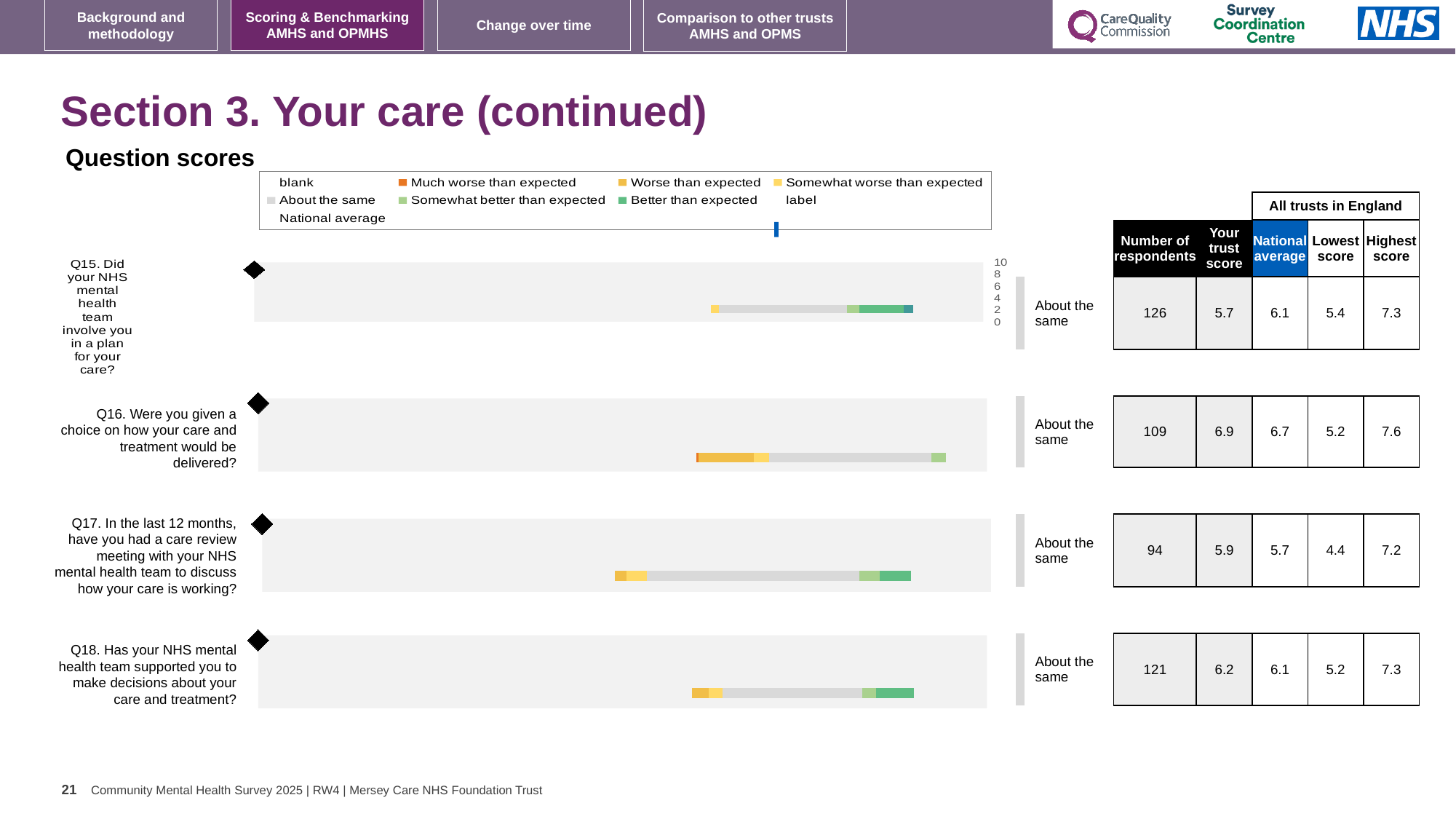
What is the number of respondents for Q15? 126 Which question has the lowest trust score? Q15 What is the trust score for Q16 (Were you given a choice on how your care and treatment would be delivered)? 6.9 How many questions (Q15 to Q18) have a bar plotted on this slide? 4 What comparison label is shown next to the bar for Q15? About the same In the legend, which colour represents 'Much worse than expected'? orange What is the lowest score among all trusts in England for Q18? 5.2 Which question has the highest trust score? Q16 For Q15, which is larger: the trust score or the national average? national average What kind of chart is used to show the question scores on this slide? bar chart What is the difference between the trust score and the national average for Q16? 0.2 What is the national average for Q17? 5.7